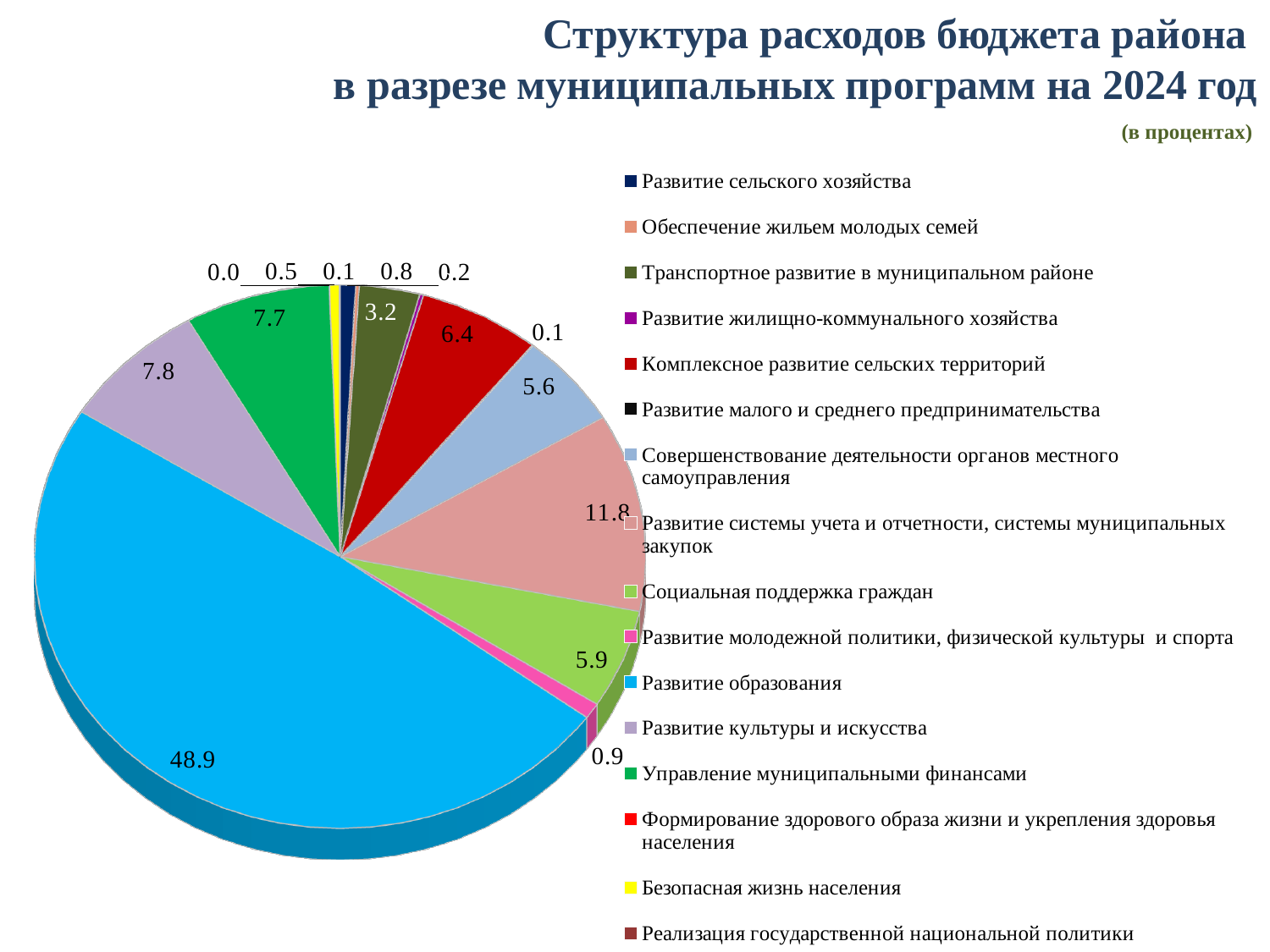
What is the value shown for Транспортное развитие в муниципальном районе? 3.2 What is the value shown for Развитие культуры и искусства? 7.8 By how many percentage points does Развитие образования exceed Развитие культуры и искусства? 41.1 What is the value shown for Управление муниципальными финансами? 7.7 What percentage of expenditure goes to Развитие образования? 48.9 What is the value shown for Комплексное развитие сельских территорий? 6.4 What is the title of the chart on the slide? Структура расходов бюджета района в разрезе муниципальных программ на 2024 год How many entries does the legend of the pie chart list? 16 What is the value shown for Социальная поддержка граждан? 5.9 Which municipal programme has the largest share of the district budget expenditure? Развитие образования Which is larger: the share for Комплексное развитие сельских территорий or for Социальная поддержка граждан? Комплексное развитие сельских территорий What kind of chart is shown on the slide? pie chart